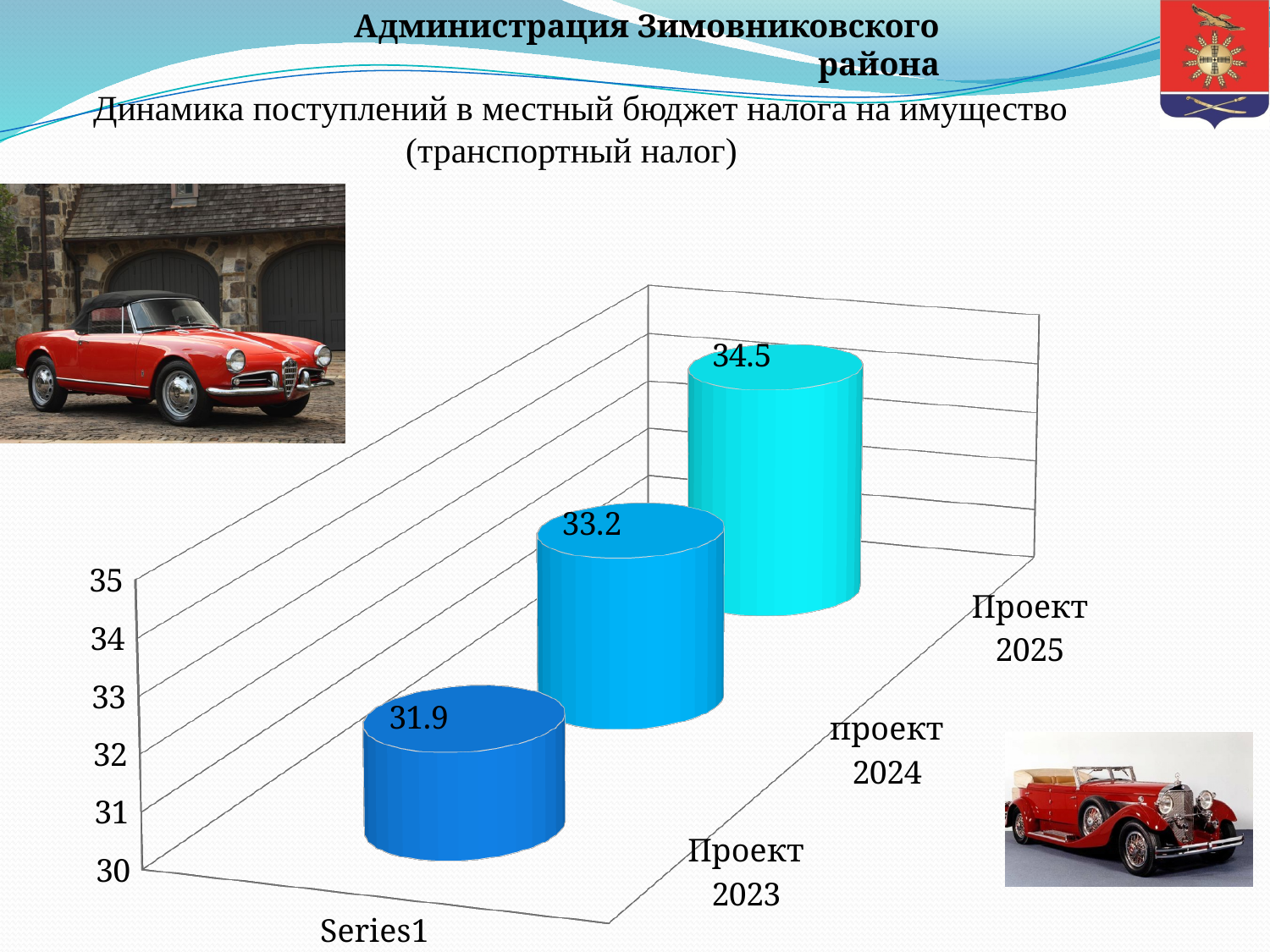
What is the value for проект 2024? 33.2 What is the value for Проект 2023? 31.9 How many categories are shown in the chart? 3 What kind of chart is shown on the slide? bar chart What is the difference between the values for Проект 2025 and Проект 2023? 2.6 Do the values rise or fall from Проект 2023 to Проект 2025? rise What is the difference between the values for проект 2024 and Проект 2023? 1.3 What is the value for Проект 2025? 34.5 Is the value for Проект 2023 greater or less than 32? less Which category has the lowest value? Проект 2023 Which is larger, the value for проект 2024 or the value for Проект 2025? Проект 2025 Which category has the highest value? Проект 2025